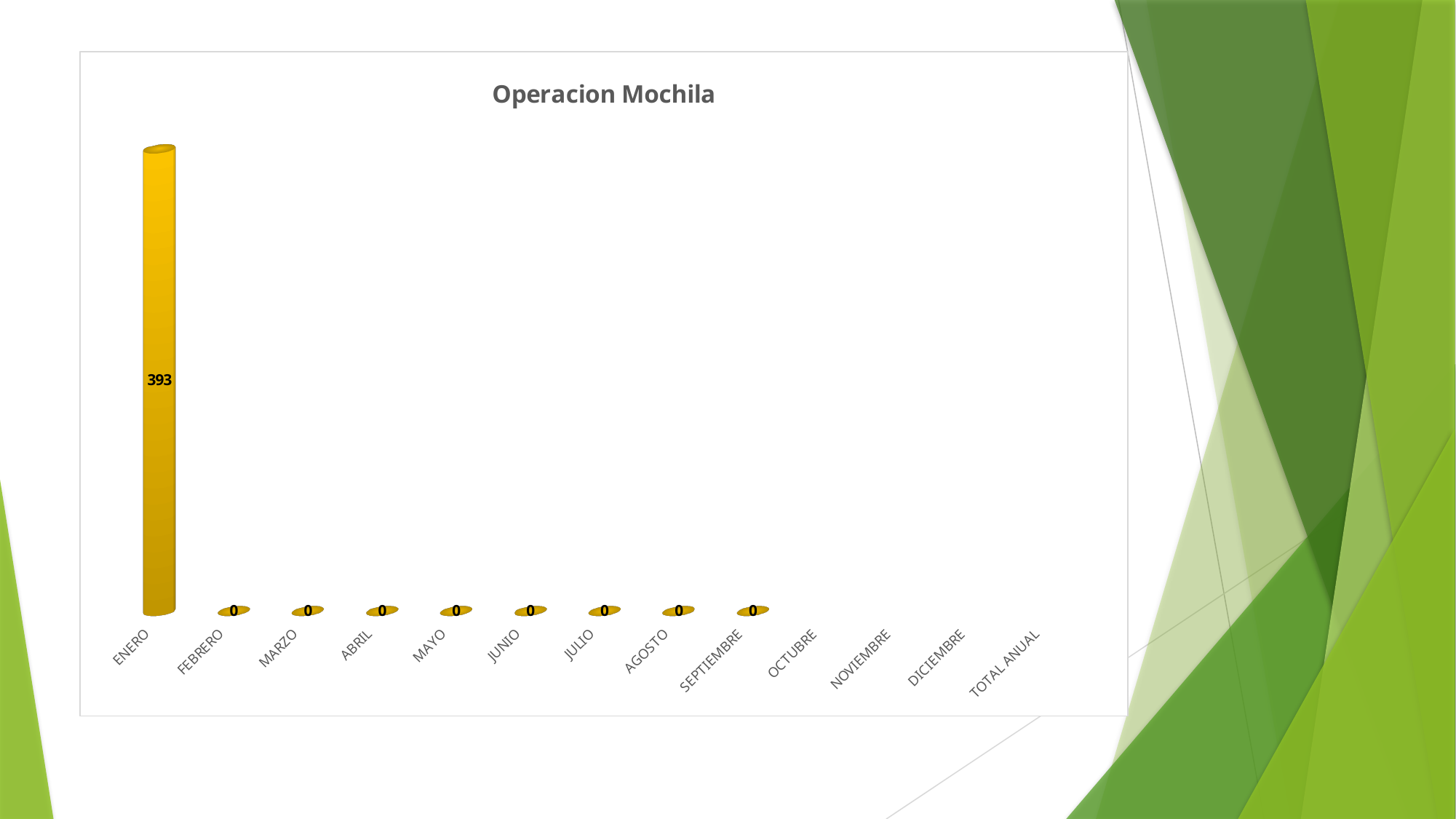
What is the value for ENERO in the Operacion Mochila chart? 393 Which category has the highest value in the Operacion Mochila chart? ENERO What is the value for MARZO in the Operacion Mochila chart? 0 What is the difference between the values for ENERO and FEBRERO? 393 Do the values rise or fall from ENERO to FEBRERO? Fall What is the title of the chart? Operacion Mochila What is the value for SEPTIEMBRE in the Operacion Mochila chart? 0 How many categories have a data label of 0 in the chart? 8 Which is larger, the value for ENERO or the value for JULIO? ENERO How many category labels are shown on the x axis of the chart? 13 What kind of chart is shown on the slide? Bar chart What colour are the bars in the chart? Yellow